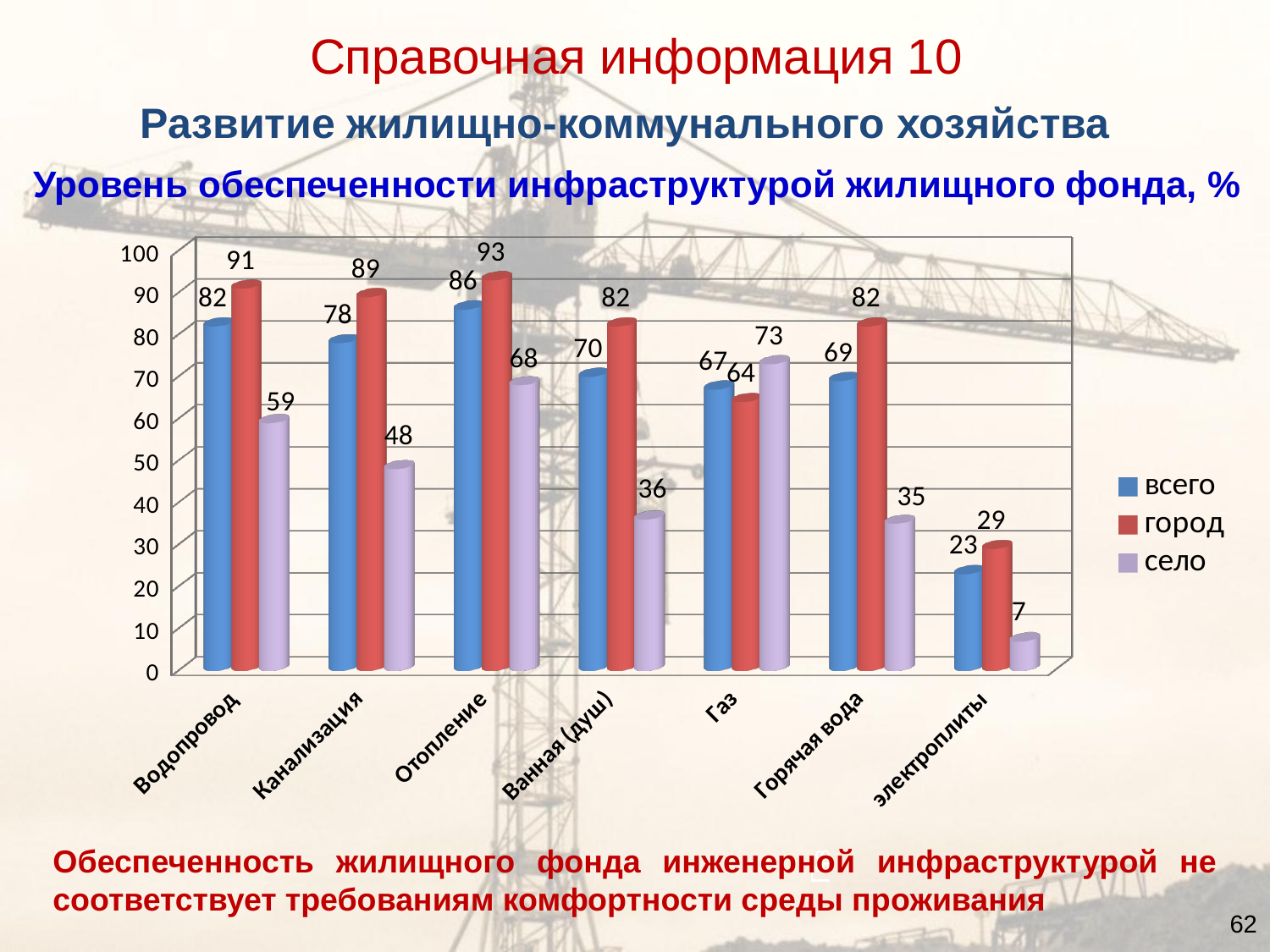
How many series does the legend list? 3 How many categories are shown on the x axis? 7 What is the value for "всего" in the "Горячая вода" category? 69 What colour are the bars for the "село" series? purple What is the value for "всего" in the "электроплиты" category? 23 In the "Газ" category, which series has the larger value: "город" or "село"? село What is the difference between the "город" and "село" values in the "Ванная (душ)" category? 46 What is the value for "город" in the "Водопровод" category? 91 Which category has the lowest value for the "село" series? электроплиты What is the value for "село" in the "Канализация" category? 48 What kind of chart is shown on the slide? bar chart Which category has the highest value for the "город" series? Отопление